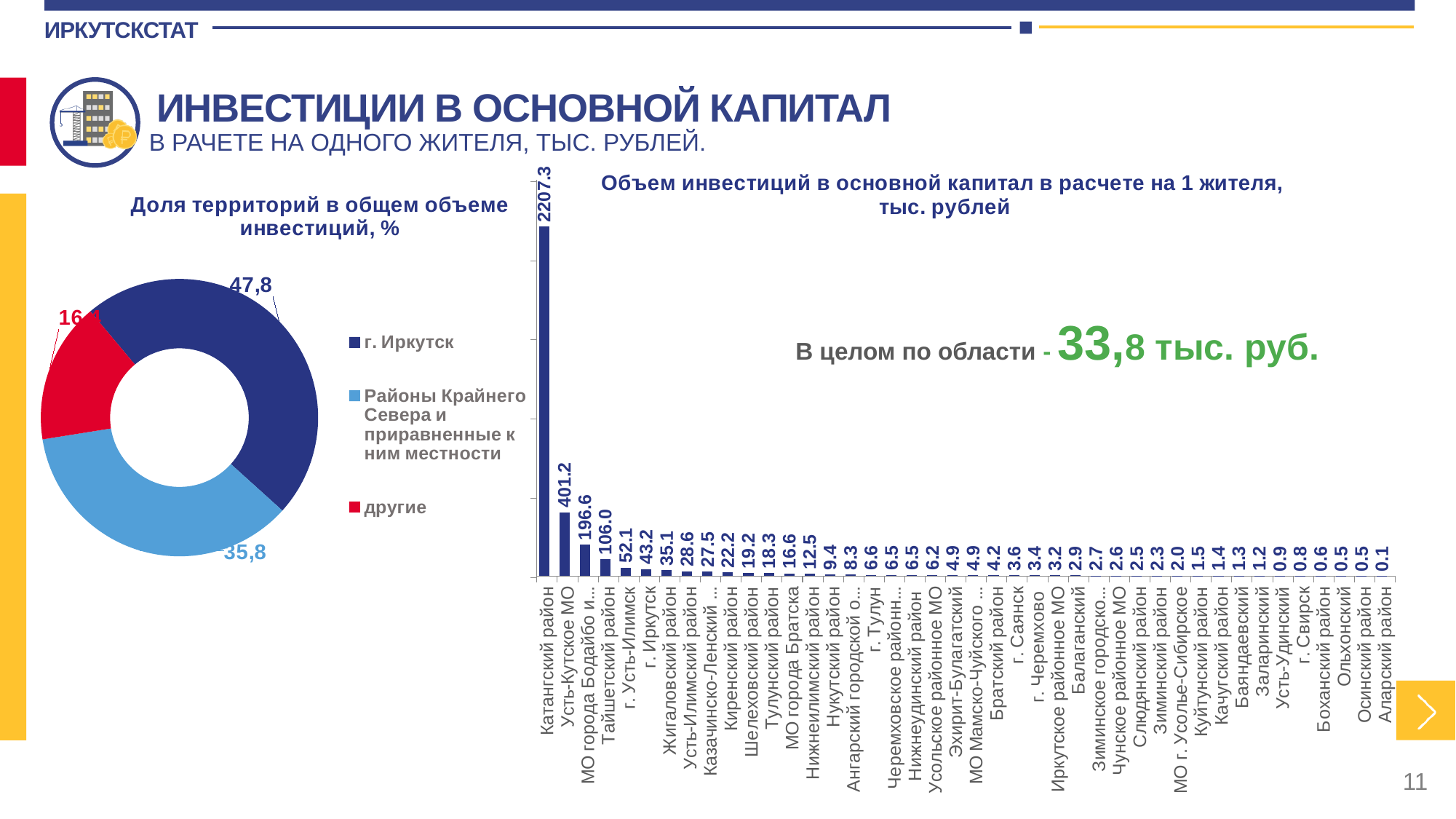
In the bar chart 'Объем инвестиций в основной капитал в расчете на 1 жителя, тыс. рублей', do the values rise or fall from left to right along the x axis? fall In the bar chart 'Объем инвестиций в основной капитал в расчете на 1 жителя, тыс. рублей', what is the value for г. Иркутск? 43.2 According to the text on the slide, what is the value of investment per resident for the region as a whole (В целом по области)? 33,8 тыс. руб. In the bar chart 'Объем инвестиций в основной капитал в расчете на 1 жителя, тыс. рублей', which territory has the lowest value? Аларский район In the pie chart 'Доля территорий в общем объеме инвестиций, %', what is the share for Районы Крайнего Севера и приравненные к ним местности? 35,8 In the bar chart 'Объем инвестиций в основной капитал в расчете на 1 жителя, тыс. рублей', which is larger: Жигаловский район or Киренский район? Жигаловский район In the bar chart 'Объем инвестиций в основной капитал в расчете на 1 жителя, тыс. рублей', what is the difference between Усть-Кутское МО and Тайшетский район? 295.2 In the bar chart 'Объем инвестиций в основной капитал в расчете на 1 жителя, тыс. рублей', what is the value for Катангский район? 2207.3 In the pie chart 'Доля территорий в общем объеме инвестиций, %', what is the share for г. Иркутск? 47,8 In the pie chart 'Доля территорий в общем объеме инвестиций, %', which category has the largest share? г. Иркутск How many categories does the legend of the pie chart 'Доля территорий в общем объеме инвестиций, %' list? 3 What kind of chart is 'Объем инвестиций в основной капитал в расчете на 1 жителя, тыс. рублей'? bar chart